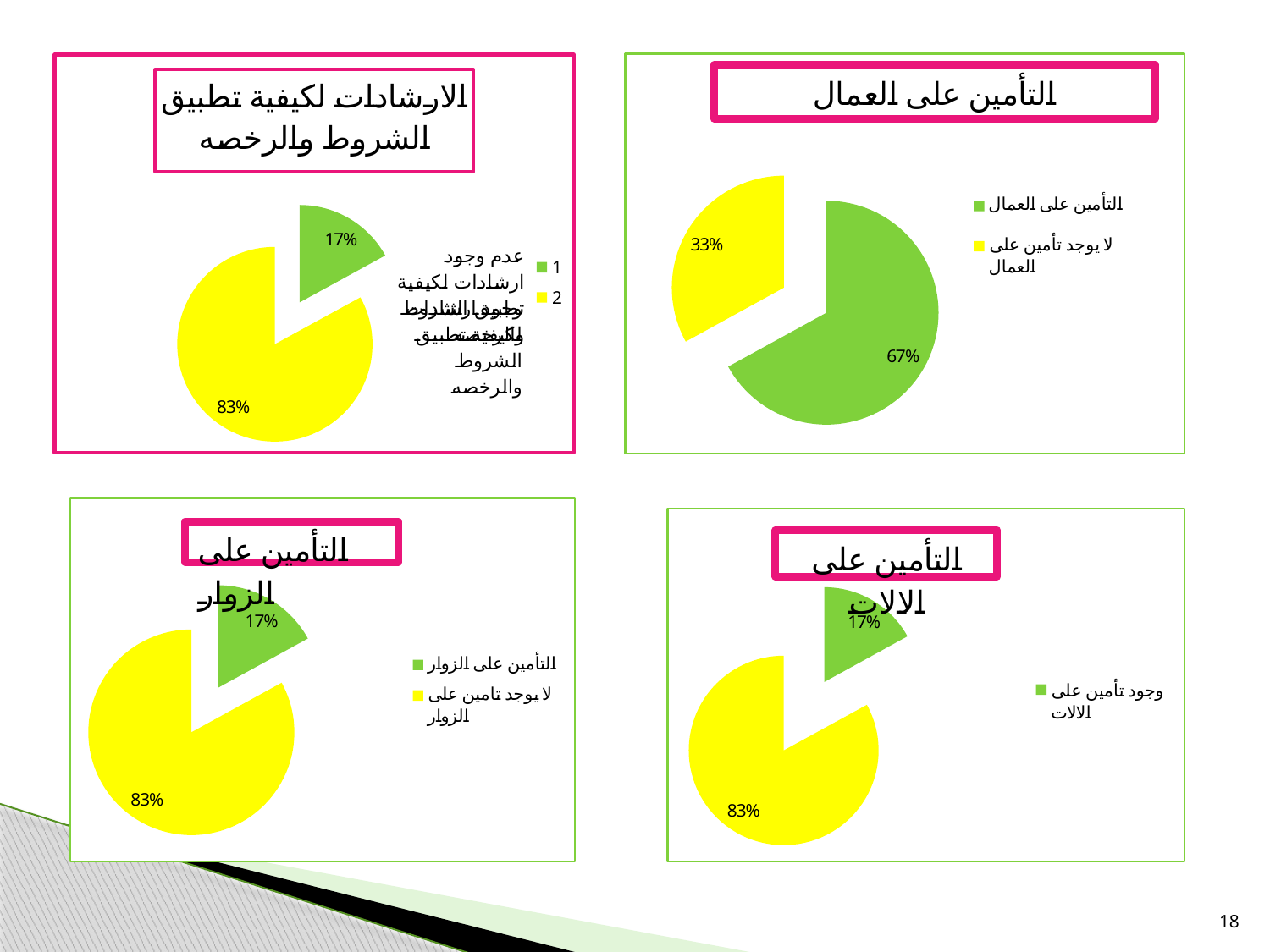
In the bottom-left chart titled "التأمين على الزوار", which slice is the smallest? التأمين على الزوار In the top-left chart titled "الارشادات لكيفية تطبيق الشروط والرخصه", what percentage is shown for the yellow slice? 83% In the top-right chart titled "التأمين على العمال", what percentage is shown for the green slice "التأمين على العمال"? 67% In the bottom-left chart titled "التأمين على الزوار", what percentage is shown for the green slice "التأمين على الزوار"? 17% In the top-right chart titled "التأمين على العمال", what percentage is shown for the yellow slice "لا يوجد تأمين على العمال"? 33% In the top-right chart titled "التأمين على العمال", which slice is larger: "التأمين على العمال" or "لا يوجد تأمين على العمال"? التأمين على العمال In the bottom-right chart titled "التأمين على الالات", what percentage is shown for the green slice? 17% What type of chart is the top-right chart titled "التأمين على العمال"? Pie chart In the bottom-right chart titled "التأمين على الالات", what percentage is shown for the yellow slice? 83% How many slices does the top-right chart titled "التأمين على العمال" have? 2 In the bottom-left chart titled "التأمين على الزوار", what percentage is shown for the yellow slice "لا يوجد تامين على الزوار"? 83% In the top-right chart titled "التأمين على العمال", what is the difference in percentage points between the two slices? 34